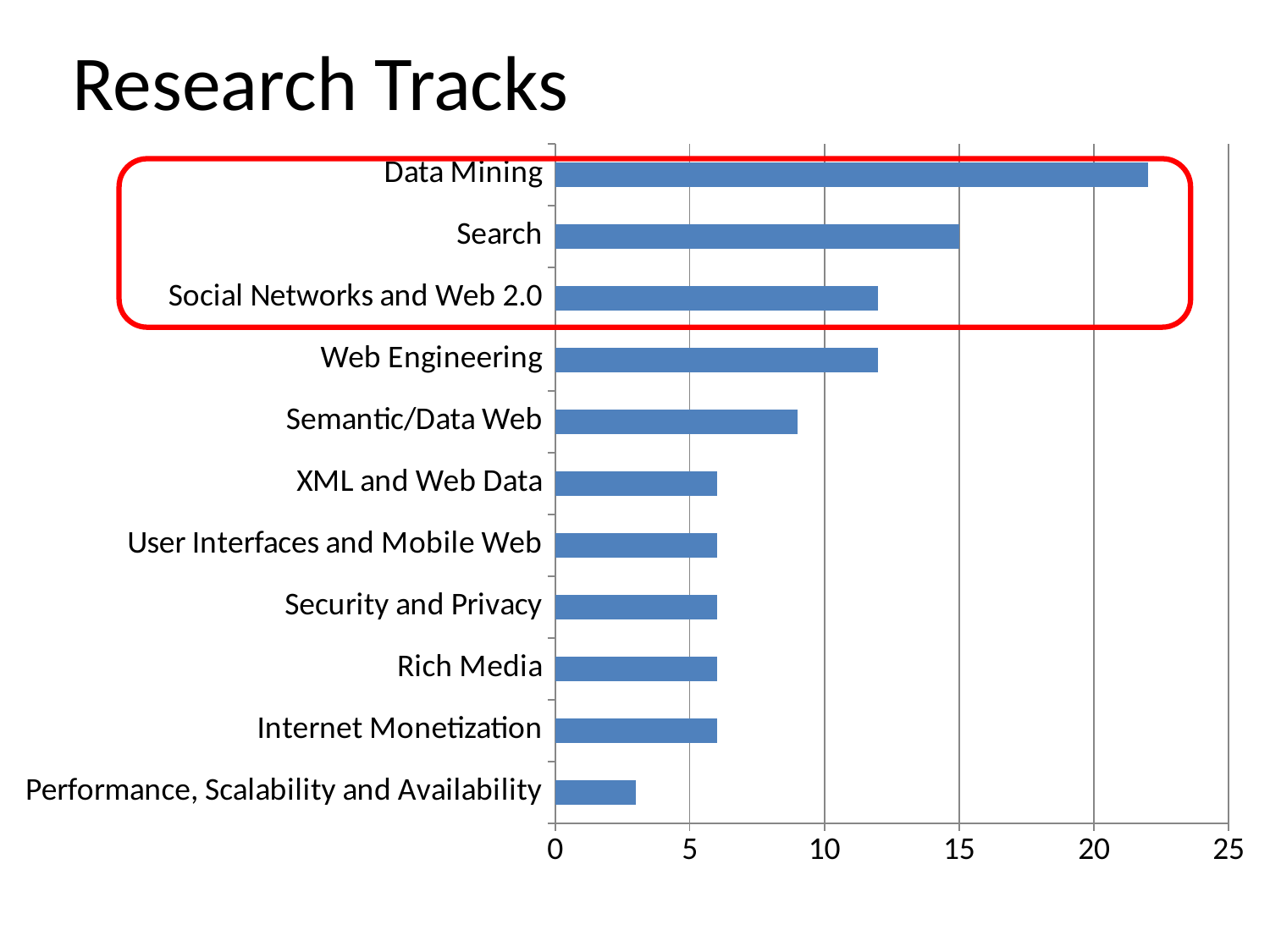
Which research track has the lowest value? Performance, Scalability and Availability Is the value for Semantic/Data Web greater or less than 10? less What kind of chart is shown on the slide? bar chart Which is larger, the value for Semantic/Data Web or the value for XML and Web Data? Semantic/Data Web What is the value for Search? 15 What is the title of the slide containing the chart? Research Tracks Is the value for Data Mining greater or less than 20? greater How many research tracks are plotted in the chart? 11 Which research tracks are enclosed by the red box on the chart? Data Mining, Search, Social Networks and Web 2.0 Is the value for Performance, Scalability and Availability greater or less than 5? less Which research track has the highest value? Data Mining Which is larger, the value for Search or the value for Web Engineering? Search